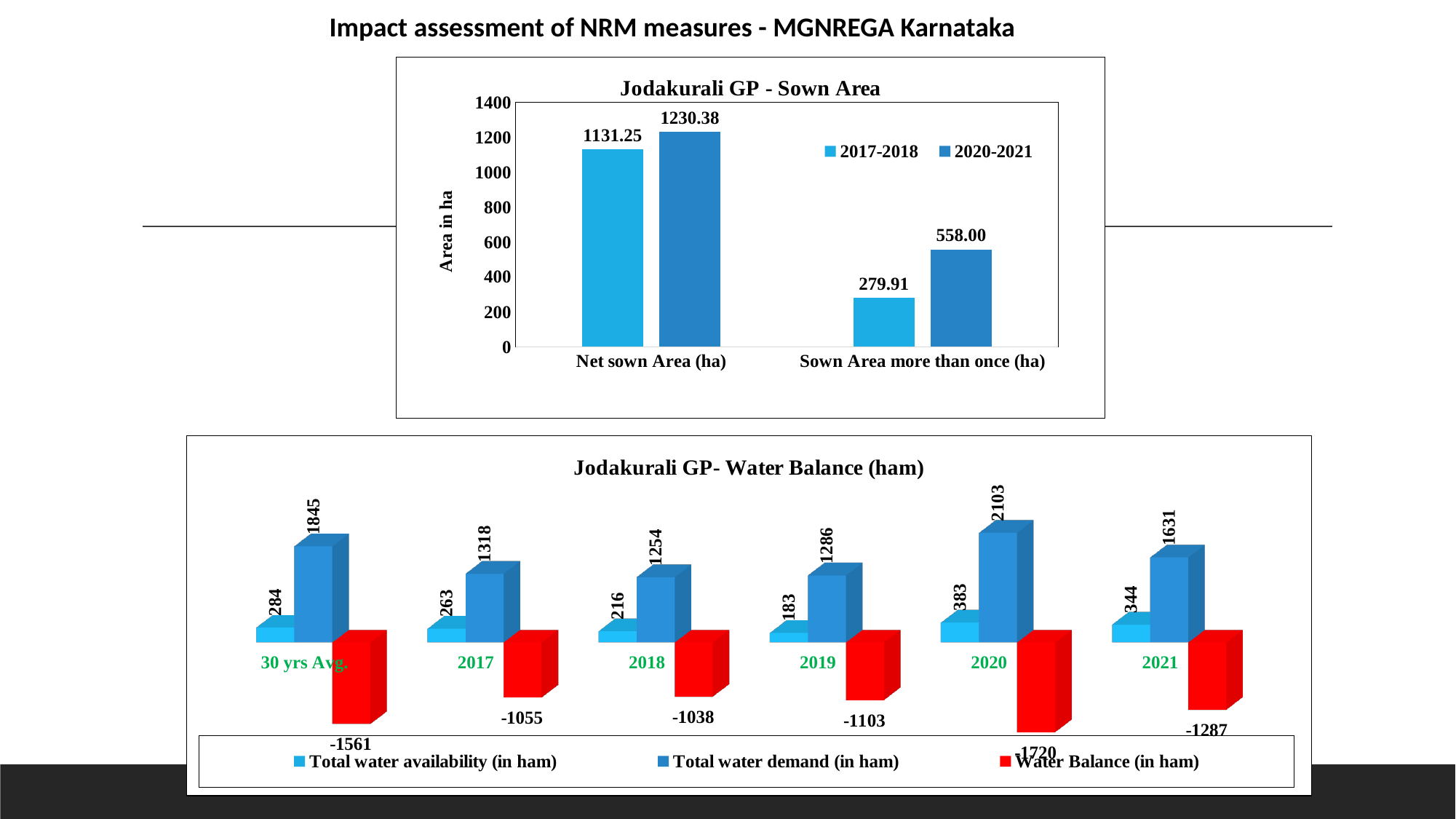
In the 'Jodakurali GP - Sown Area' chart, what is the value for Sown Area more than once (ha) in 2017-2018? 279.91 In the 'Jodakurali GP - Sown Area' chart, what is the Net sown Area (ha) for 2020-2021? 1230.38 In the 'Jodakurali GP- Water Balance (ham)' chart, which category has the highest Total water demand (in ham)? 2020 In the 'Jodakurali GP- Water Balance (ham)' chart, what is the Water Balance (in ham) for 2018? -1038 In the 'Jodakurali GP- Water Balance (ham)' chart, how many categories are shown on the x axis? 6 In the 'Jodakurali GP - Sown Area' chart, what is the difference between the 2020-2021 and 2017-2018 values for Sown Area more than once (ha)? 278.09 In the 'Jodakurali GP - Sown Area' chart, how many series does the legend list? 2 In the 'Jodakurali GP- Water Balance (ham)' chart, is the Total water availability (in ham) larger for 2020 or for 2021? 2020 What kind of chart is 'Jodakurali GP - Sown Area'? Bar chart In the 'Jodakurali GP- Water Balance (ham)' chart, which year has the lowest Total water availability (in ham)? 2019 In the 'Jodakurali GP- Water Balance (ham)' chart, what is the difference between Total water demand and Total water availability for 2017? 1055 In the 'Jodakurali GP- Water Balance (ham)' chart, what is the Total water demand (in ham) for 2020? 2103